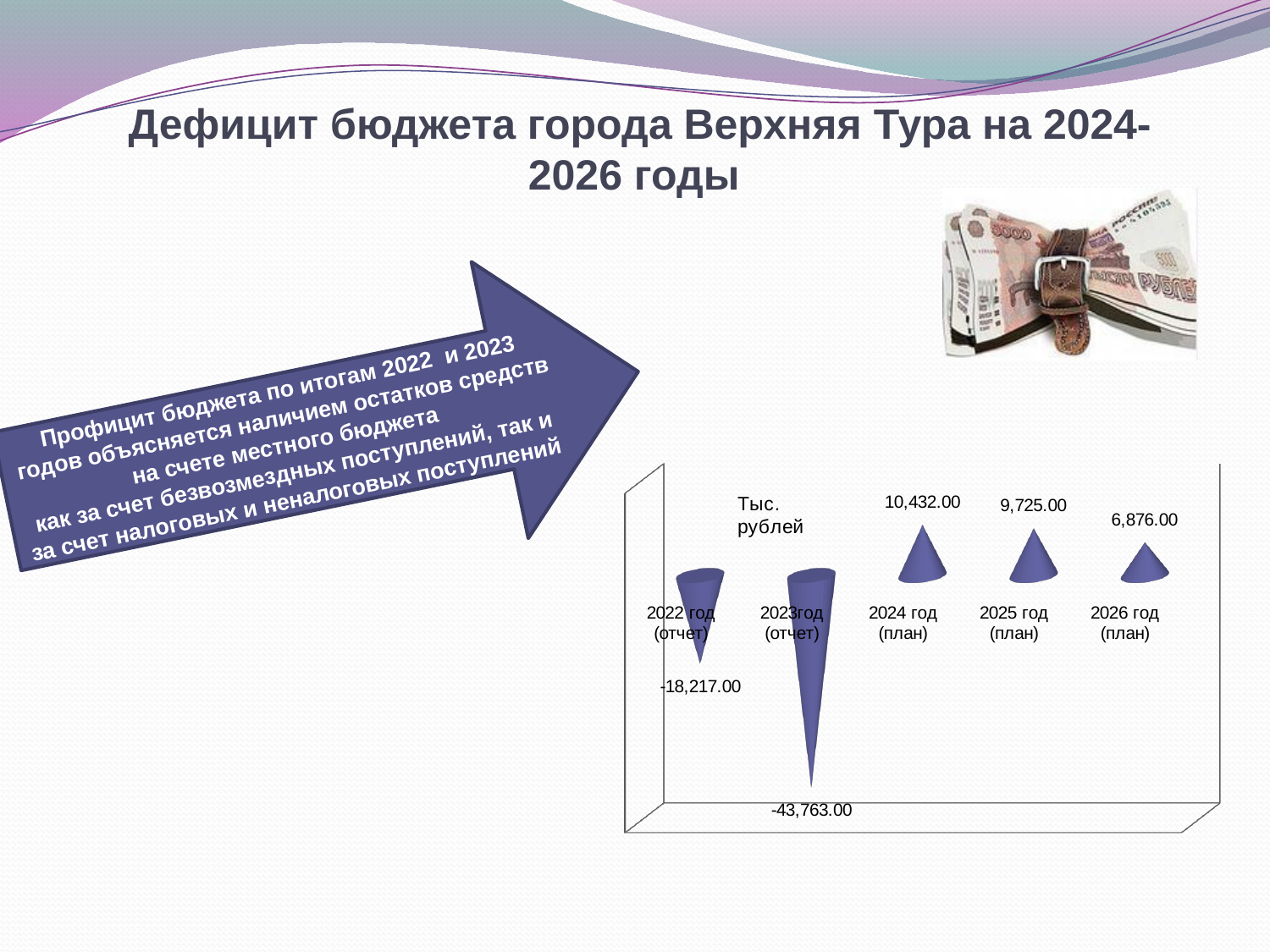
Which is larger, the value for 2022 год (отчет) or 2023год (отчет)? 2022 год (отчет) Do the values rise or fall from 2024 год (план) to 2026 год (план)? fall How many categories are shown in the chart? 5 What is the value for 2024 год (план)? 10,432.00 What is the value for 2023год (отчет)? -43,763.00 Which category has the lowest value? 2023год (отчет) What is the difference between the values for 2024 год (план) and 2025 год (план)? 707.00 Which category has the highest value? 2024 год (план) What is the value for 2022 год (отчет)? -18,217.00 What unit is indicated on the chart? Тыс. рублей What is the value for 2026 год (план)? 6,876.00 What is the difference between the values for 2025 год (план) and 2026 год (план)? 2,849.00